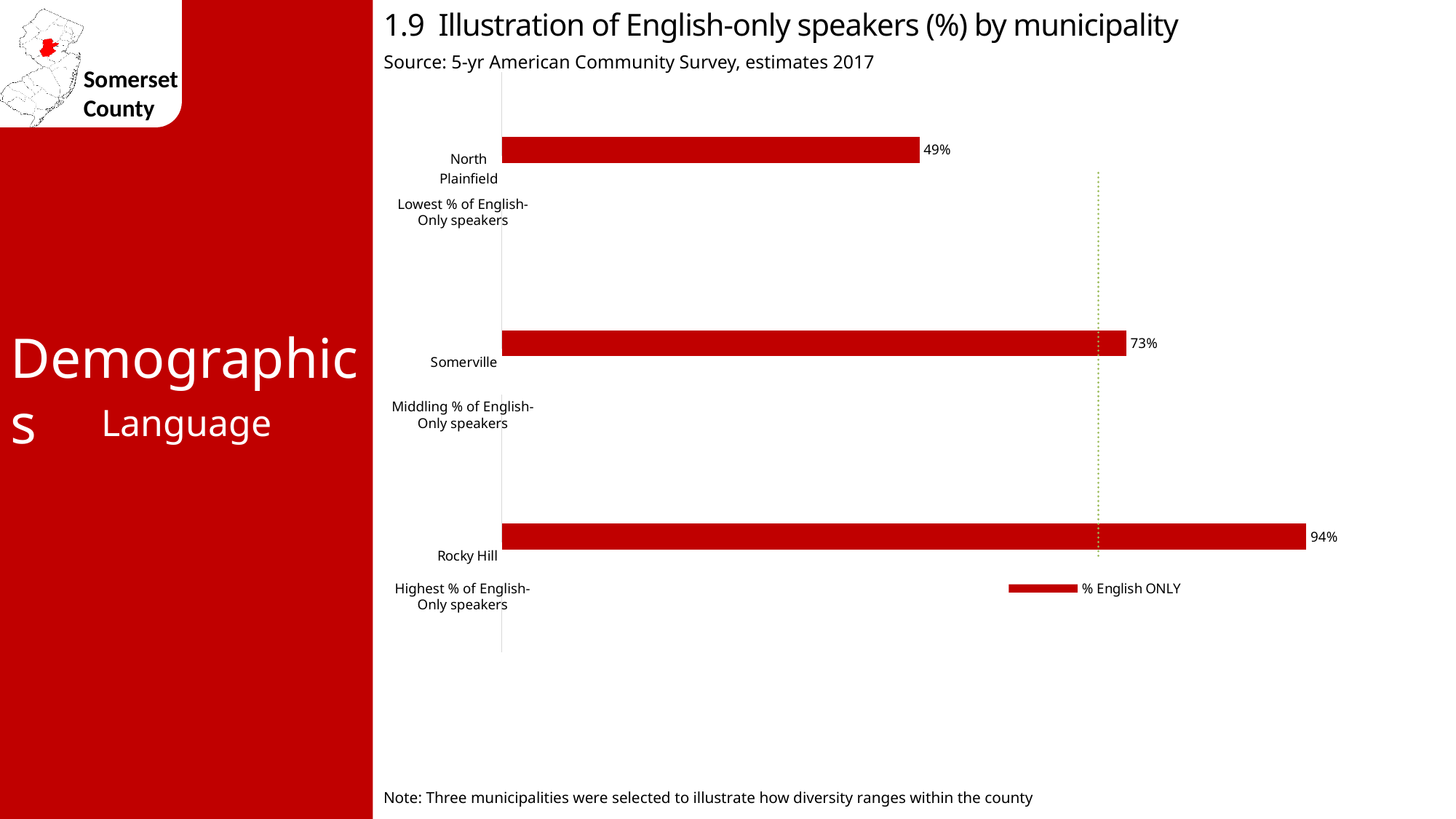
Which municipality has the lowest percentage of English-only speakers? North Plainfield What kind of chart is shown on the slide? Bar chart What is the legend entry for the series in the chart? % English ONLY How many municipalities are shown in the chart? 3 Which has a higher percentage of English-only speakers, Somerville or North Plainfield? Somerville What percentage of English-only speakers is shown for North Plainfield? 49% Which municipality has the highest percentage of English-only speakers? Rocky Hill What is the difference in percentage points between Somerville and North Plainfield? 24 What is the difference in percentage points between Rocky Hill and North Plainfield? 45 What percentage of English-only speakers is shown for Somerville? 73% What percentage of English-only speakers is shown for Rocky Hill? 94% How many series does the legend list? 1